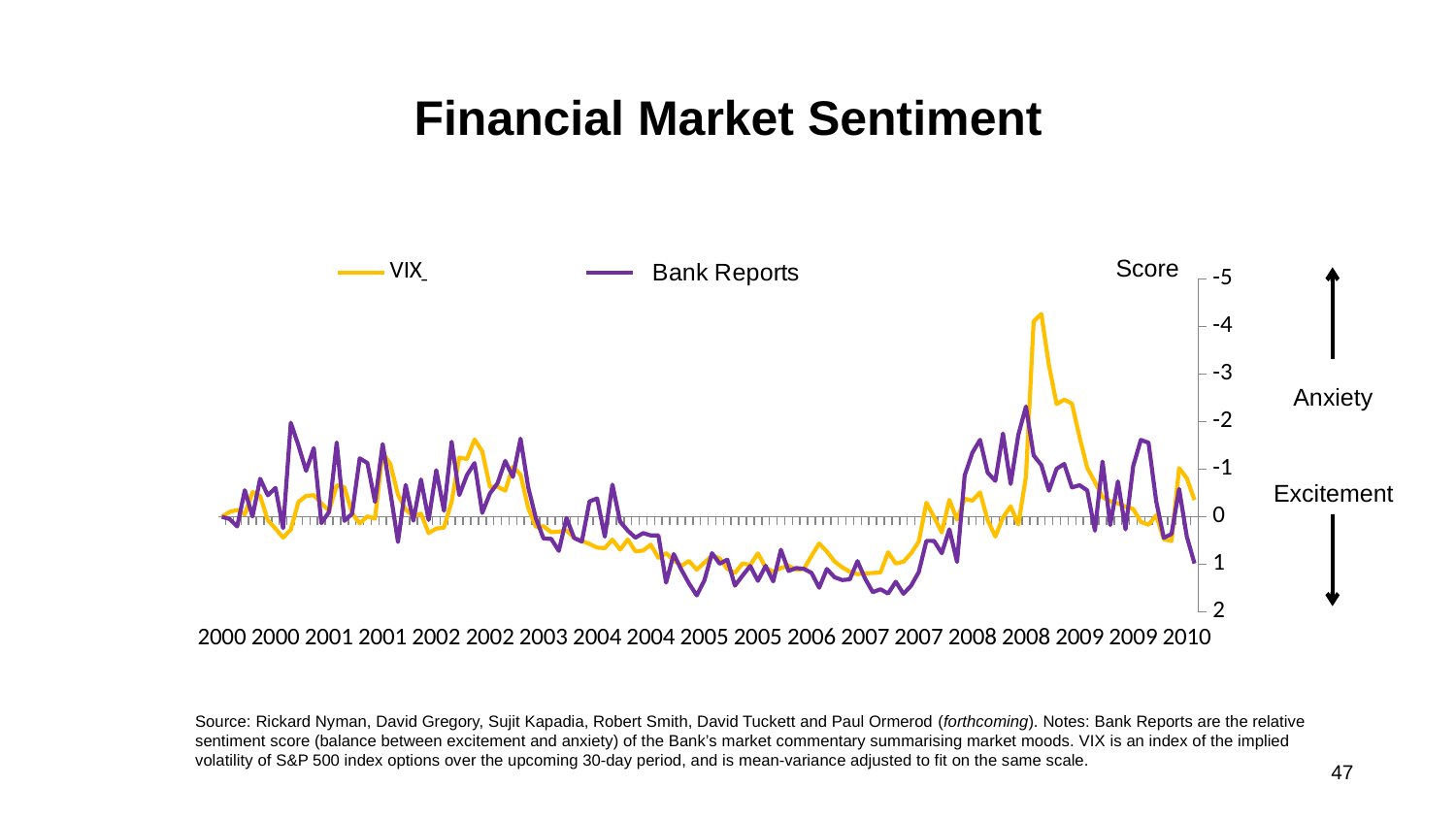
In which year does the VIX series reach its highest anxiety peak? 2008 Which direction on the vertical axis is labelled Anxiety, up or down? Up How many series does the legend list? 2 What type of chart is shown on the slide? Line chart Which series reaches the highest anxiety peak on the chart? VIX Does the Bank Reports line cross beyond the -3 gridline at any point? No What is the title of the chart? Financial Market Sentiment What are the two series named in the legend? VIX and Bank Reports Does the VIX line cross beyond the -3 gridline at its 2008 peak? Yes Between 2003 and 2006, do both series move toward excitement or toward anxiety? Toward excitement